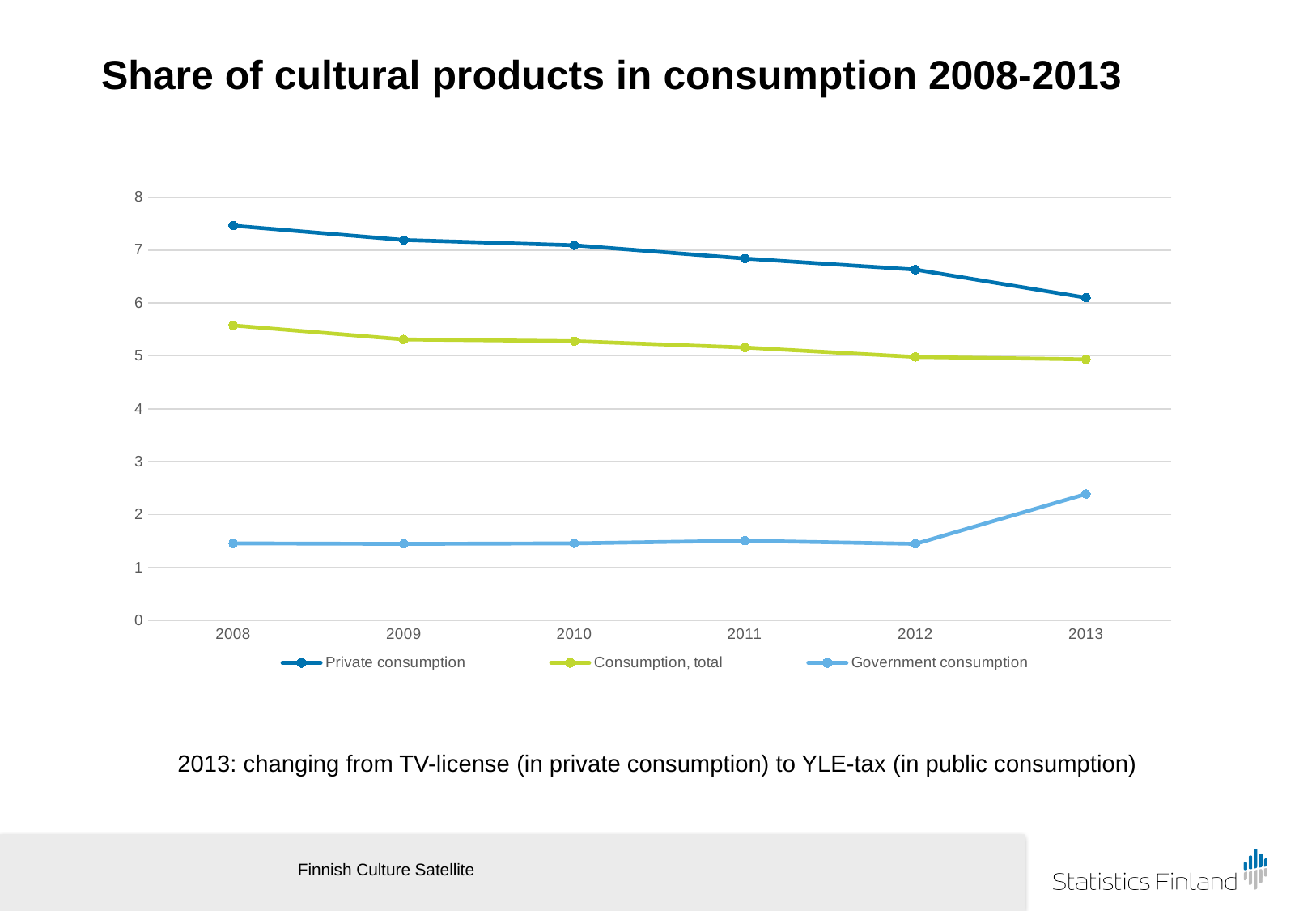
In which year is Government consumption highest? 2013 How many years are plotted along the x axis? 6 Which is larger in 2011, Private consumption or Consumption, total? Private consumption Does the Consumption, total line rise or fall from 2008 to 2013? fall Is the value for Government consumption in 2013 greater or less than 2? greater How many series does the legend list? 3 In which year is Private consumption highest? 2008 What is the title of the chart? Share of cultural products in consumption 2008-2013 Does the Private consumption line rise or fall from 2008 to 2013? fall What kind of chart is shown on the slide? line chart Is the value for Private consumption in 2008 greater or less than 7? greater